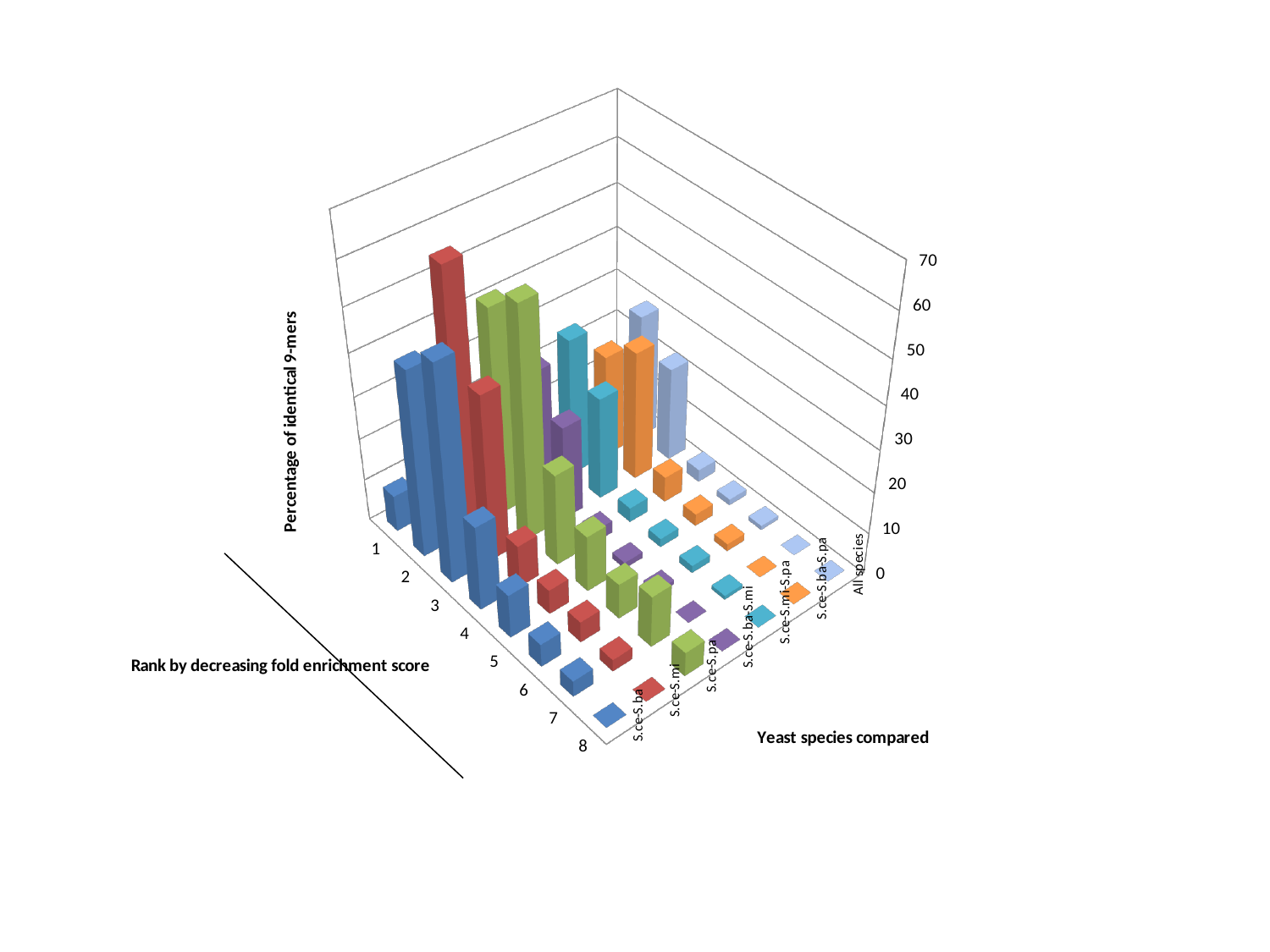
For S.ce-S.mi, which rank has the highest percentage of identical 9-mers? 2 Is the value for S.ce-S.ba at rank 8 greater or less than 10? less For S.ce-S.mi, is the value at rank 2 larger or smaller than the value at rank 8? larger How many rank categories are shown along the 'Rank by decreasing fold enrichment score' axis? 8 What is the maximum value shown on the vertical axis? 70 What kind of chart is shown on the slide? 3D bar chart What is the title of the vertical axis? Percentage of identical 9-mers Is the value for S.ce-S.mi at rank 2 greater or less than 30? greater What is the label of the depth axis listing the species pairs? Yeast species compared How many yeast species comparisons are plotted along the 'Yeast species compared' axis? 7 Do the percentages of identical 9-mers generally rise or fall as the rank increases from 2 to 8? fall Which species comparison is listed last along the 'Yeast species compared' axis? All species